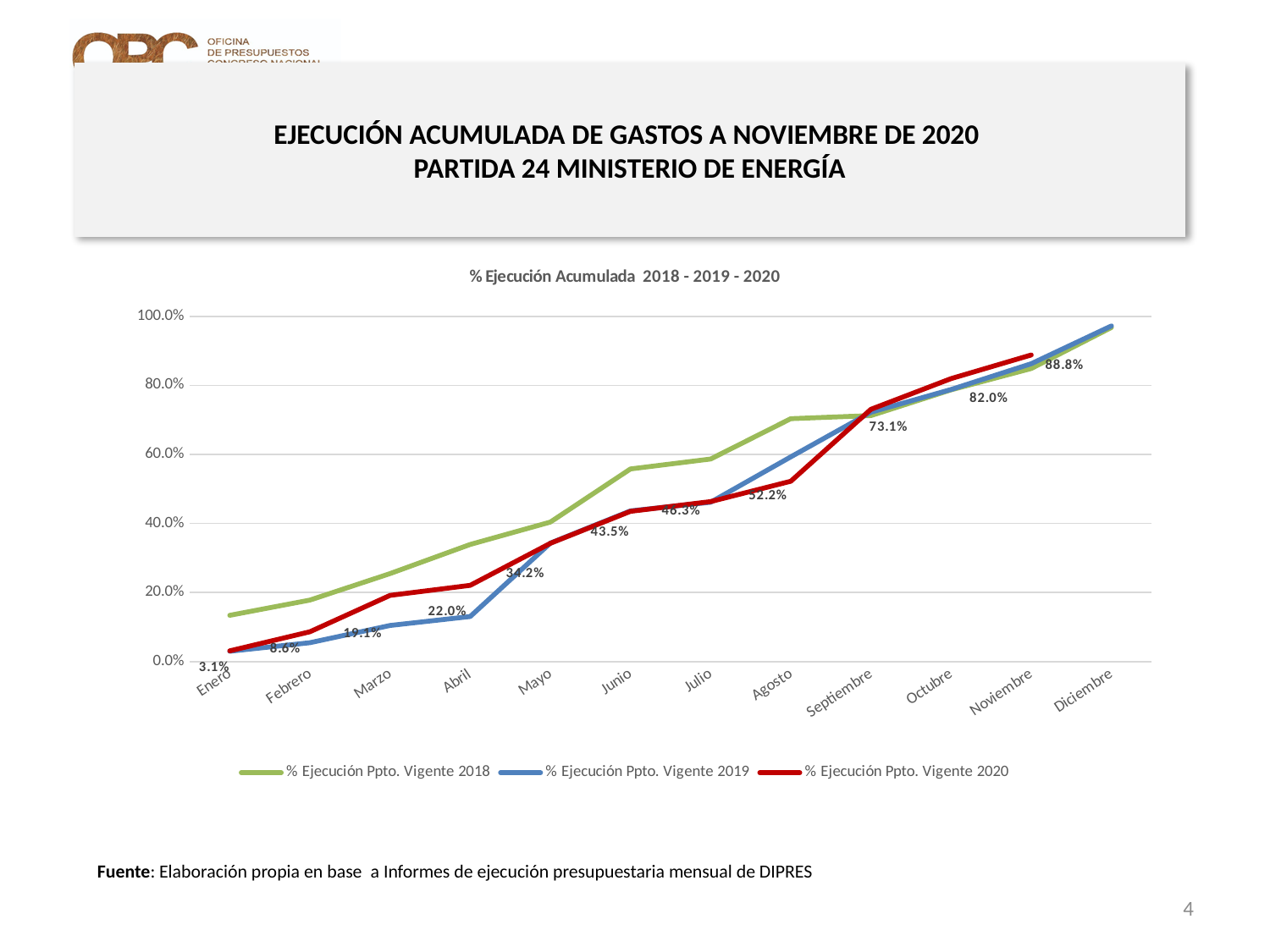
Do the values of % Ejecución Ppto. Vigente 2020 rise or fall from Enero to Noviembre? rise What is the value of % Ejecución Ppto. Vigente 2020 in Noviembre? 88.8% What is the value of % Ejecución Ppto. Vigente 2020 in Enero? 3.1% Is the value for % Ejecución Ppto. Vigente 2018 in Junio greater or less than 40.0%? greater What kind of chart is shown on the slide? line chart In Marzo, which series is larger: % Ejecución Ppto. Vigente 2018 or % Ejecución Ppto. Vigente 2020? % Ejecución Ppto. Vigente 2018 What is the value of % Ejecución Ppto. Vigente 2020 in Octubre? 82.0% How many series does the legend list? 3 By how many percentage points did % Ejecución Ppto. Vigente 2020 increase from Octubre to Noviembre? 6.8% What is the value of % Ejecución Ppto. Vigente 2020 in Septiembre? 73.1% What is the value of % Ejecución Ppto. Vigente 2020 in Abril? 22.0% How many months are shown along the x axis? 12